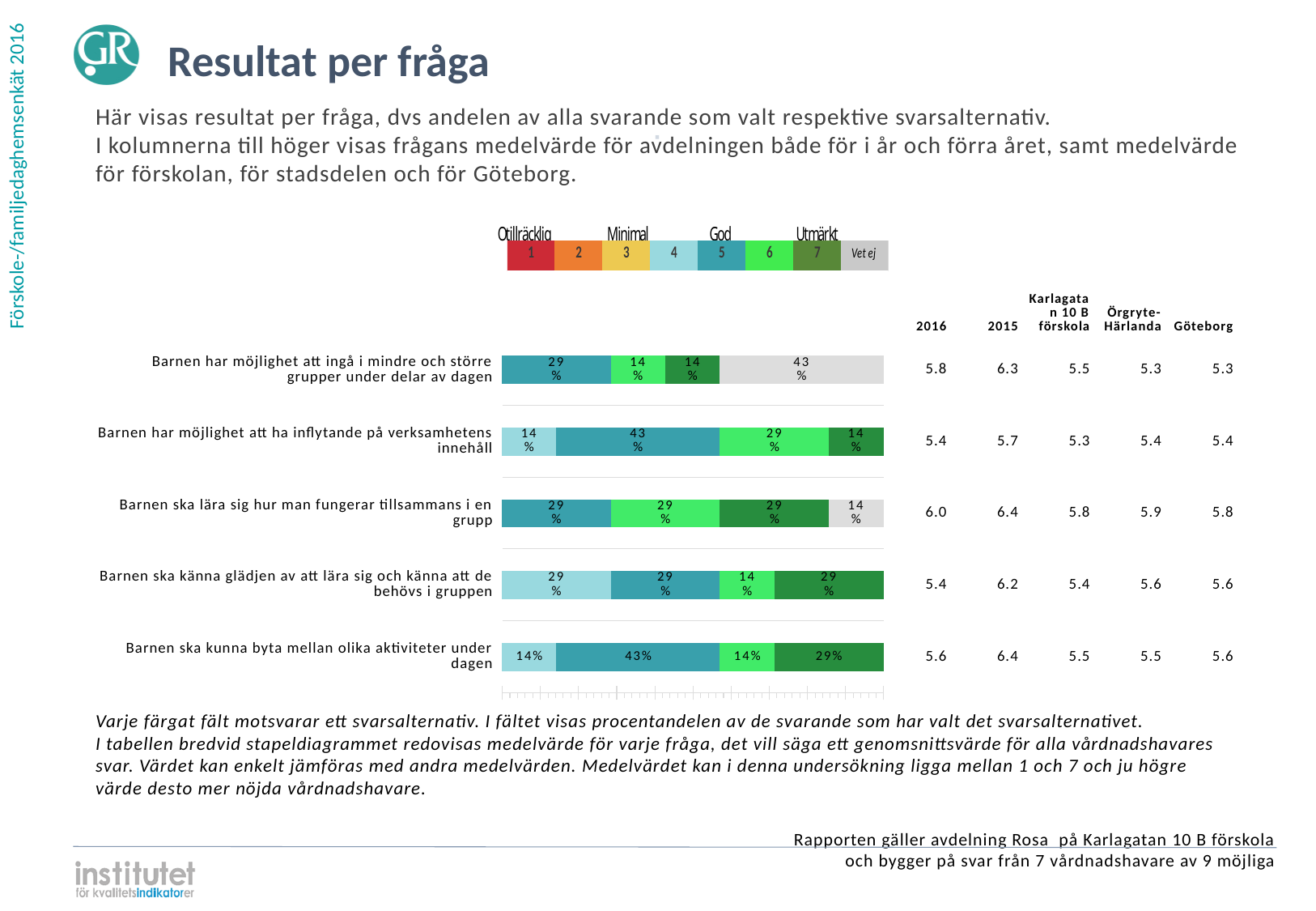
What percentage of respondents answered 'Vet ej' for 'Barnen har möjlighet att ingå i mindre och större grupper under delar av dagen'? 43% For 'Barnen har möjlighet att ha inflytande på verksamhetens innehåll', what is the difference between the share choosing answer 5 (43%) and the share choosing answer 7 (14%)? 29 percentage points What percentage chose answer 7 (dark green) for 'Barnen ska känna glädjen av att lära sig och känna att de behövs i gruppen'? 29% What label does the legend give to answer alternatives 1 and 2? Otillräcklig Which bar has the largest 'Vet ej' segment? Barnen har möjlighet att ingå i mindre och större grupper under delar av dagen What percentage chose answer 5 (teal) for 'Barnen ska kunna byta mellan olika aktiviteter under dagen'? 43% For 'Barnen ska kunna byta mellan olika aktiviteter under dagen', which is larger: the share for answer 5 or the share for answer 7? Answer 5 What is the 2016 mean value shown for 'Barnen ska lära sig hur man fungerar tillsammans i en grupp'? 6.0 How many answer alternatives does the legend above the chart list, including 'Vet ej'? 8 What percentage answered 'Vet ej' for 'Barnen ska lära sig hur man fungerar tillsammans i en grupp'? 14% What kind of chart is used to show the results per question on this slide? Stacked bar chart How many questions (bars) are shown in the chart? 5